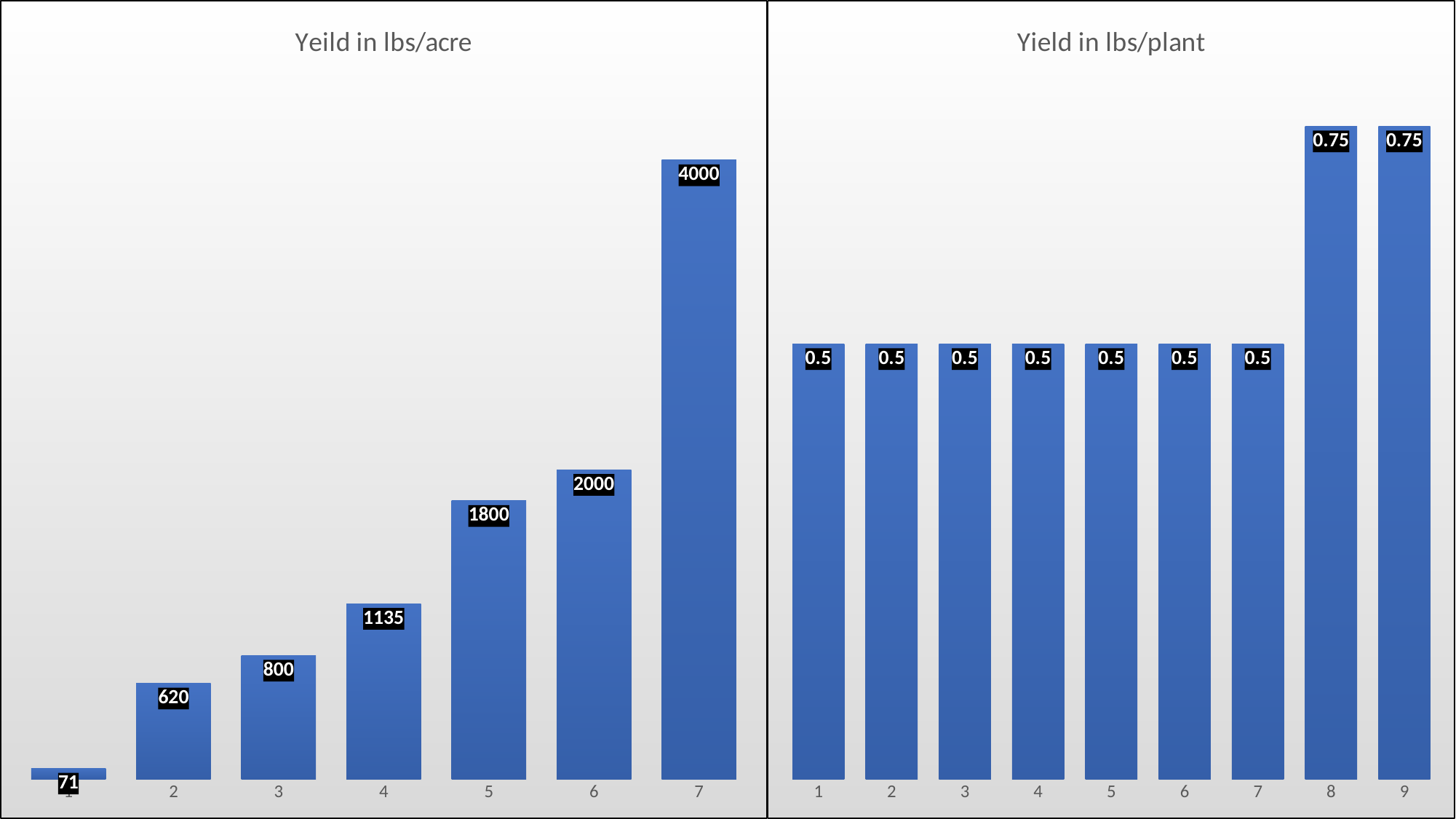
In the 'Yeild in lbs/acre' chart, how many categories are plotted? 7 In the 'Yield in lbs/plant' chart, which is larger, the value for category 9 or the value for category 7? category 9 In the 'Yeild in lbs/acre' chart, what is the value for category 2? 620 In the 'Yeild in lbs/acre' chart, what is the value for category 4? 1135 In the 'Yeild in lbs/acre' chart, do the values rise or fall from category 1 to category 7? rise In the 'Yeild in lbs/acre' chart, which category has the lowest value? 1 In the 'Yeild in lbs/acre' chart, what is the difference between the values for category 7 and category 6? 2000 In the 'Yeild in lbs/acre' chart, which category has the highest value? 7 In the 'Yield in lbs/plant' chart, what is the value for category 8? 0.75 What kind of chart is the 'Yield in lbs/plant' chart? bar chart In the 'Yield in lbs/plant' chart, how many categories are plotted? 9 In the 'Yield in lbs/plant' chart, what is the value for category 3? 0.5